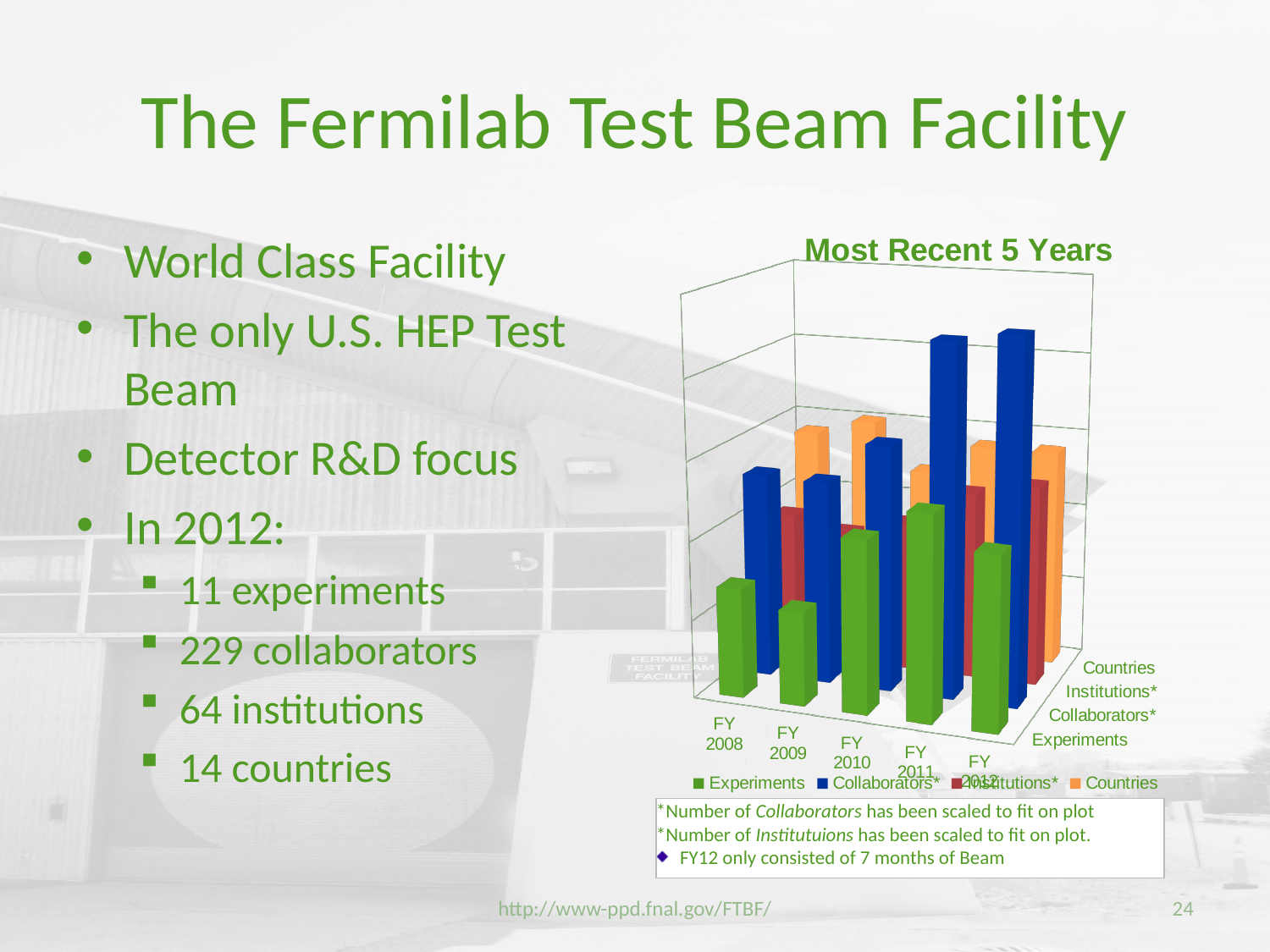
Is the Collaborators* bar taller for FY 2012 or for FY 2008? FY 2012 Is the Experiments bar taller for FY 2011 or for FY 2009? FY 2011 In which fiscal year is the Experiments bar the shortest? FY 2009 In which fiscal year is the Experiments bar the tallest? FY 2011 Which fiscal year is the first category on the x axis of the chart? FY 2008 How many series does the chart's legend list? 4 Which series in the chart is drawn in green? Experiments Is the Collaborators* bar taller for FY 2011 or for FY 2009? FY 2011 What is the title of the chart? Most Recent 5 Years How many fiscal years are plotted on the x axis of the chart? 5 Do the Experiments bars rise or fall from FY 2009 to FY 2011? rise What kind of chart is shown under the title "Most Recent 5 Years"? bar chart